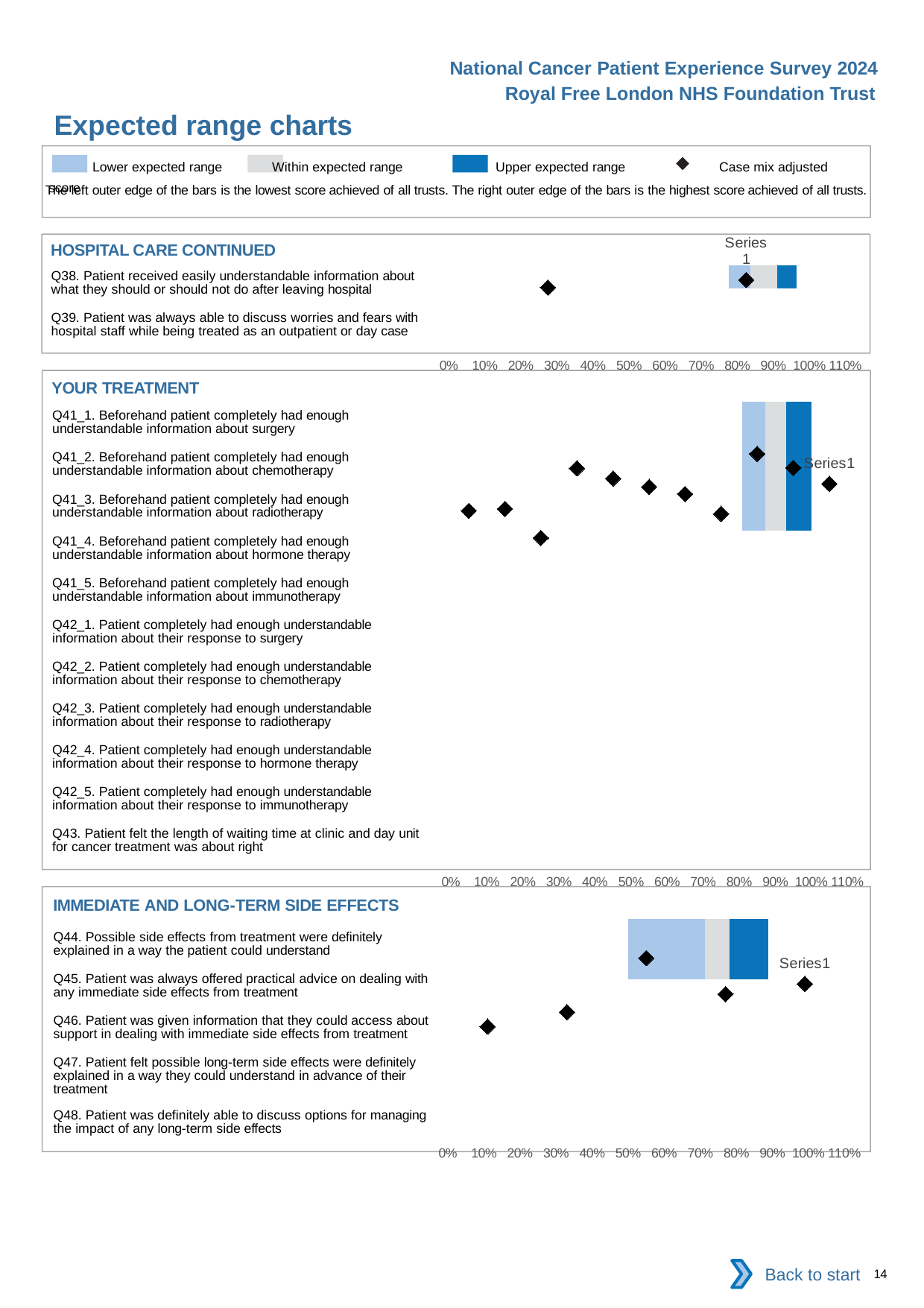
How many charts are shown on the slide? 3 In the IMMEDIATE AND LONG-TERM SIDE EFFECTS chart, is the leftmost diamond marker greater or less than 20%? less In the HOSPITAL CARE CONTINUED chart, how many survey questions are listed as categories? 2 In the HOSPITAL CARE CONTINUED chart, is the leftmost diamond marker greater or less than 40%? less What is the highest tick label shown on the x axis of the YOUR TREATMENT chart? 110% In the YOUR TREATMENT chart, is the rightmost diamond marker greater or less than 90%? greater In the IMMEDIATE AND LONG-TERM SIDE EFFECTS chart, how many survey questions are listed as categories? 5 Which legend entry is shown with a dark blue colour? Upper expected range What kind of chart is used in the YOUR TREATMENT section? Bar chart How many entries does the legend at the top of the slide list? 4